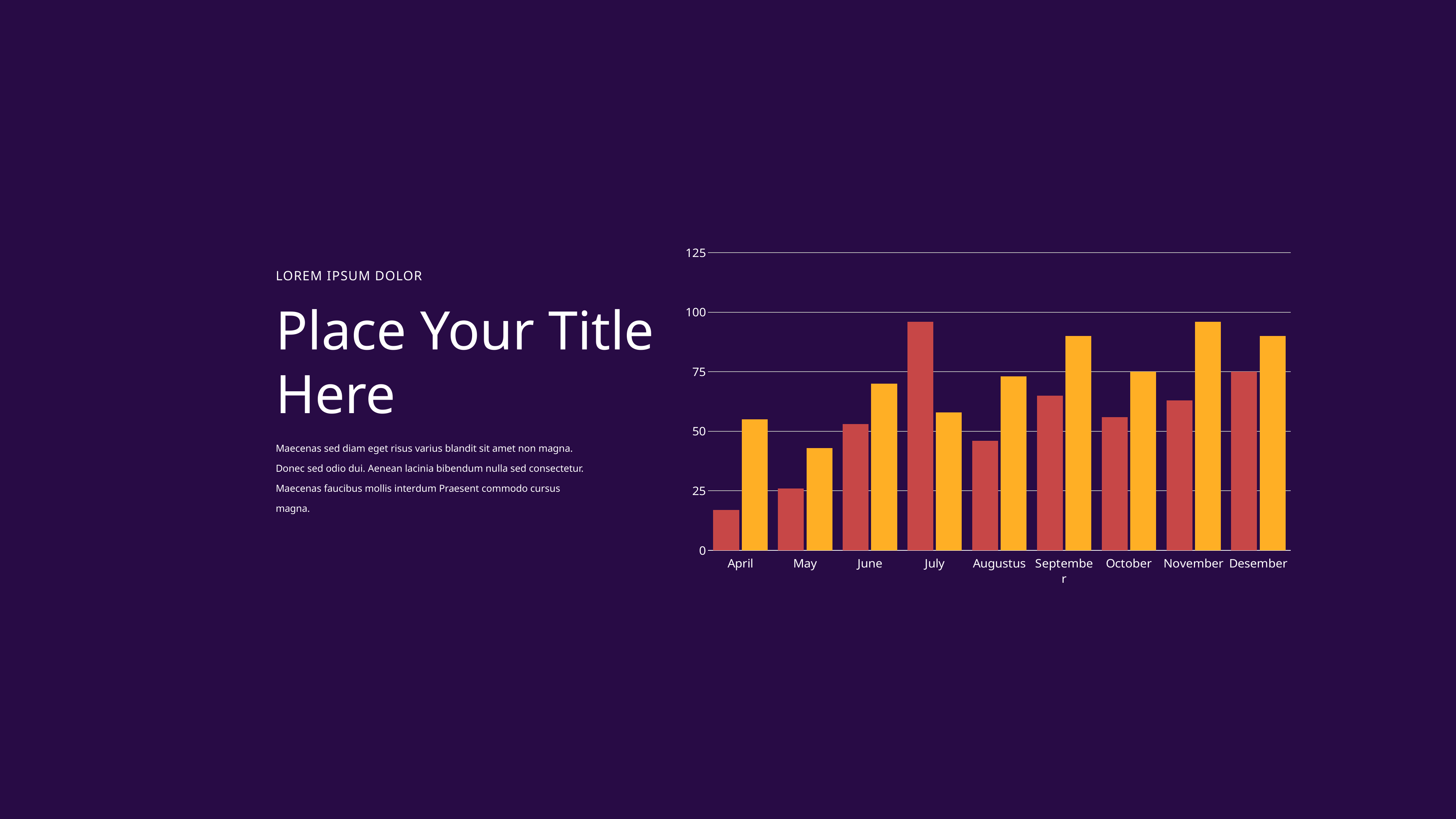
Which month has the tallest red bar? July Is the yellow bar for November greater or less than 75? greater Do the red bars rise or fall from April to July? rise How many categories are shown on the x axis of the chart? 9 In July, which bar is taller, the red one or the yellow one? red Is the yellow bar for June greater or less than 75? less In April, which bar is taller, the red one or the yellow one? yellow Which month has the shortest red bar? April What kind of chart is shown on the slide? bar chart Is the red bar for July greater or less than 75? greater Which month has the shortest yellow bar? May